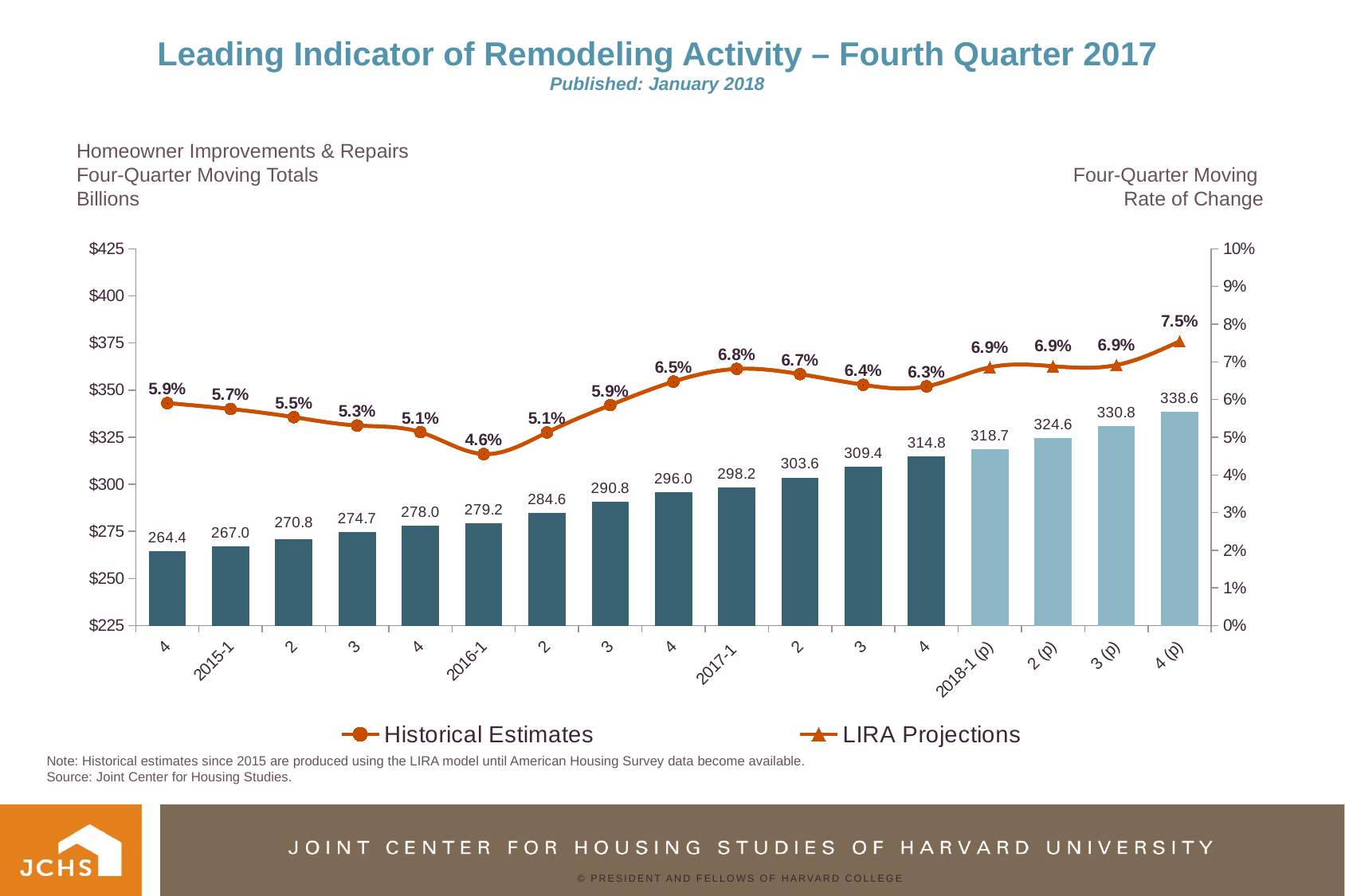
What kind of chart is shown on the slide? Combined bar and line chart How many bars are plotted on the chart? 17 What is the four-quarter moving total for 2017-1? 298.2 What is the projected four-quarter moving total for 4 (p) of 2018? 338.6 Which is larger, the rate of change for quarter 4 of 2016 or quarter 4 of 2017? Quarter 4 of 2016 (6.5%) Which quarter has the lowest four-quarter moving rate of change? 2016-1 What is the difference between the four-quarter moving totals for 2018-1 (p) and 2017-1? 20.5 Do the four-quarter moving totals rise or fall from left to right across the chart? Rise What are the two legend entries on the chart? Historical Estimates and LIRA Projections Which quarter has the highest four-quarter moving rate of change? 4 (p) of 2018 What is the four-quarter moving rate of change for 2016-1? 4.6% How many series does the legend list? 2